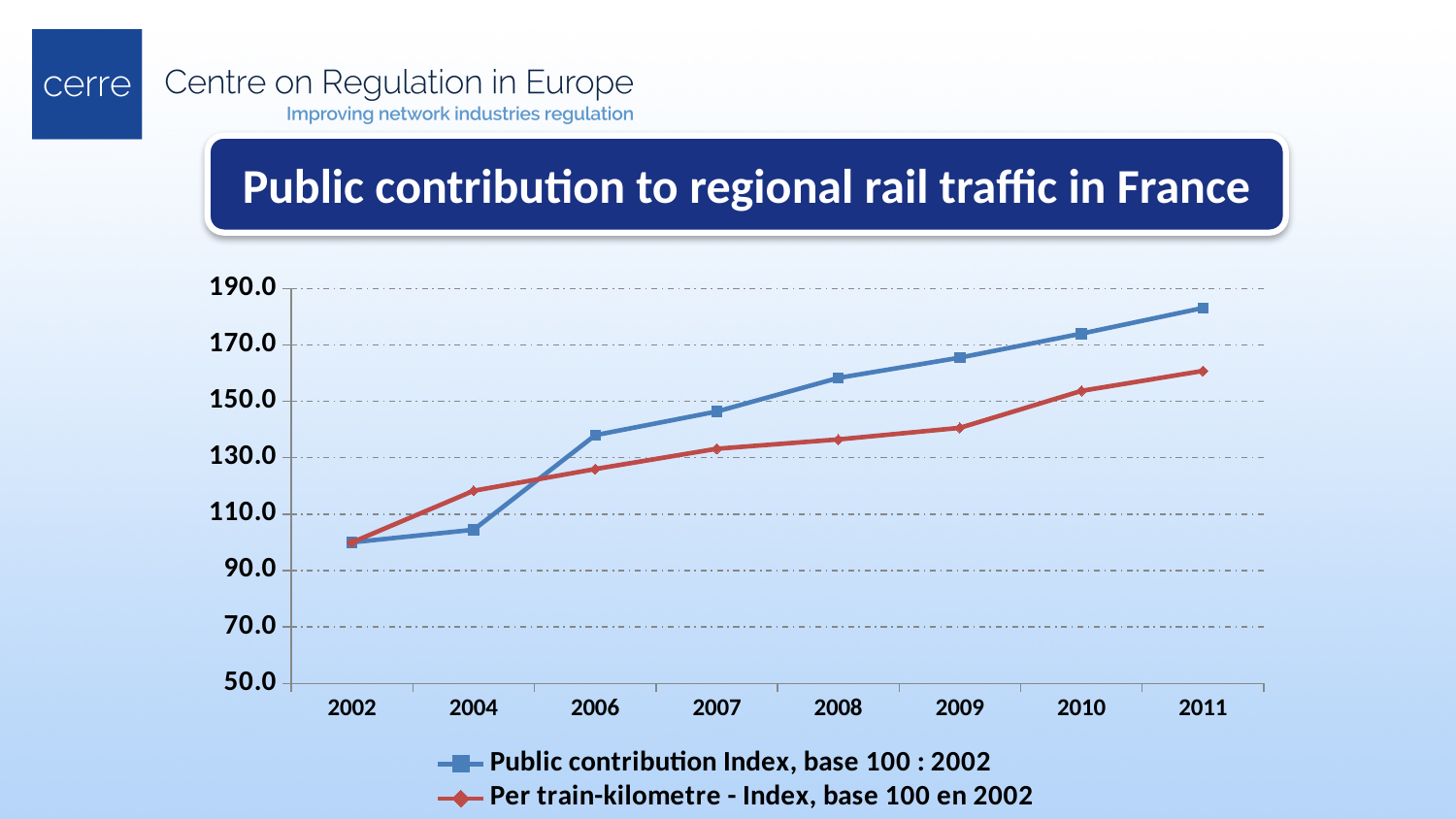
In which year is the Per train-kilometre index at its lowest? 2002 How many series does the legend list? 2 In 2006, which series has the higher value: Public contribution Index or Per train-kilometre index? Public contribution Index Is the Per train-kilometre index value for 2011 greater or less than 170? less How many years are plotted along the x axis? 8 In which year is the Public contribution Index at its highest? 2011 Is the Per train-kilometre index value for 2009 greater or less than 130? greater Do the values of the Public contribution Index rise or fall from 2002 to 2011? rise Is the Public contribution Index value for 2011 greater or less than 170? greater What kind of chart is shown on the slide? line chart In 2004, which series has the higher value: Public contribution Index or Per train-kilometre index? Per train-kilometre index